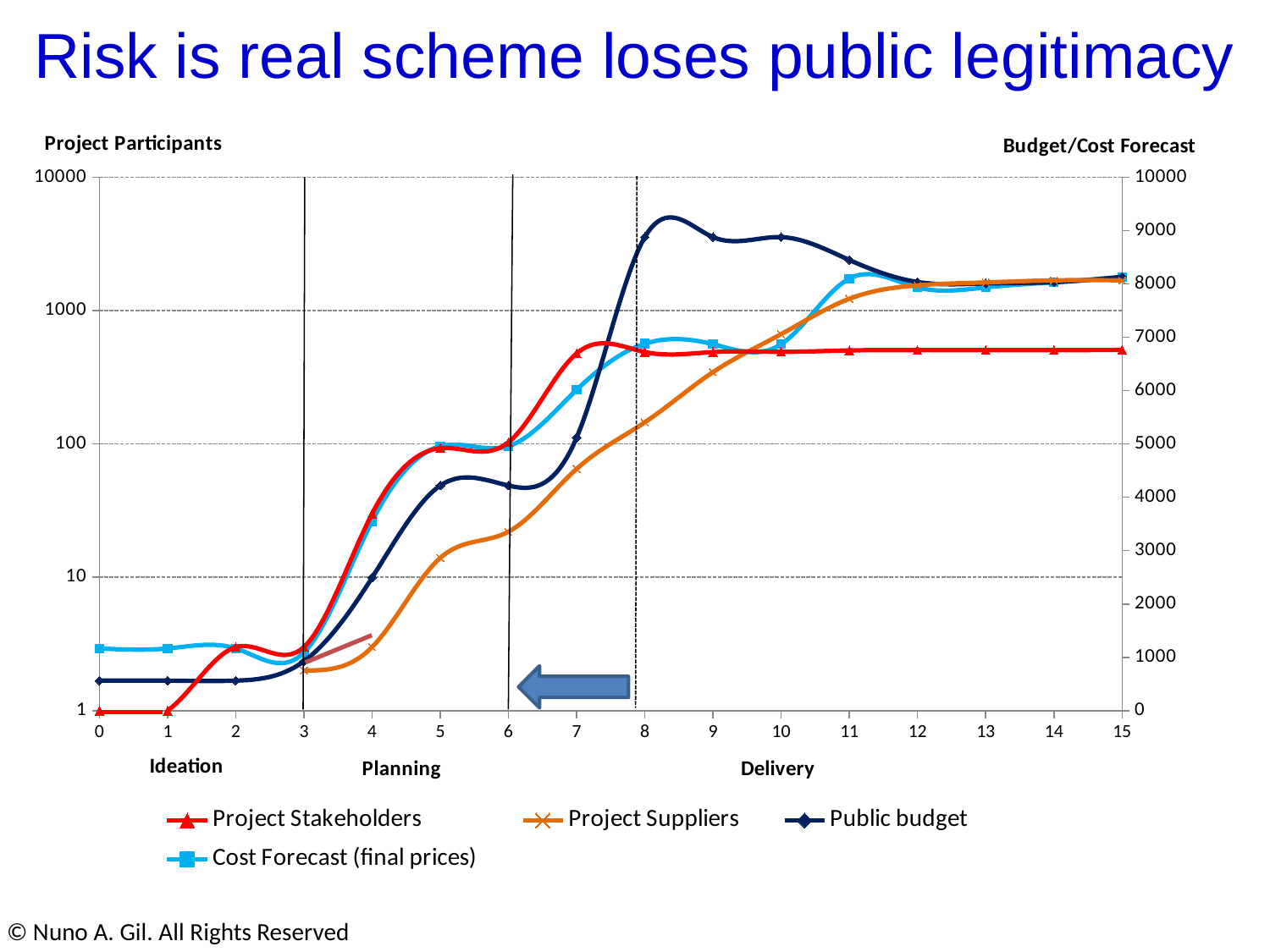
Is the value for Project Stakeholders at x = 10 greater or less than 100? greater How many series does the legend list? 4 Is the Cost Forecast (final prices) at x = 0 greater or less than 2000? less At x = 7, which is larger: Project Stakeholders or Project Suppliers? Project Stakeholders Does the Project Suppliers line rise or fall overall from x = 3 to x = 15? Rises What is the value of Project Stakeholders at x = 0? 1 What kind of chart is shown on the slide? Line chart What are the three project phases labelled below the x axis? Ideation, Planning, Delivery Is the value for Project Suppliers at x = 4 greater or less than 10? less At x = 15, which series has the higher value: Project Stakeholders or Project Suppliers? Project Suppliers At x = 8, which is larger: Public budget or Cost Forecast (final prices)? Public budget